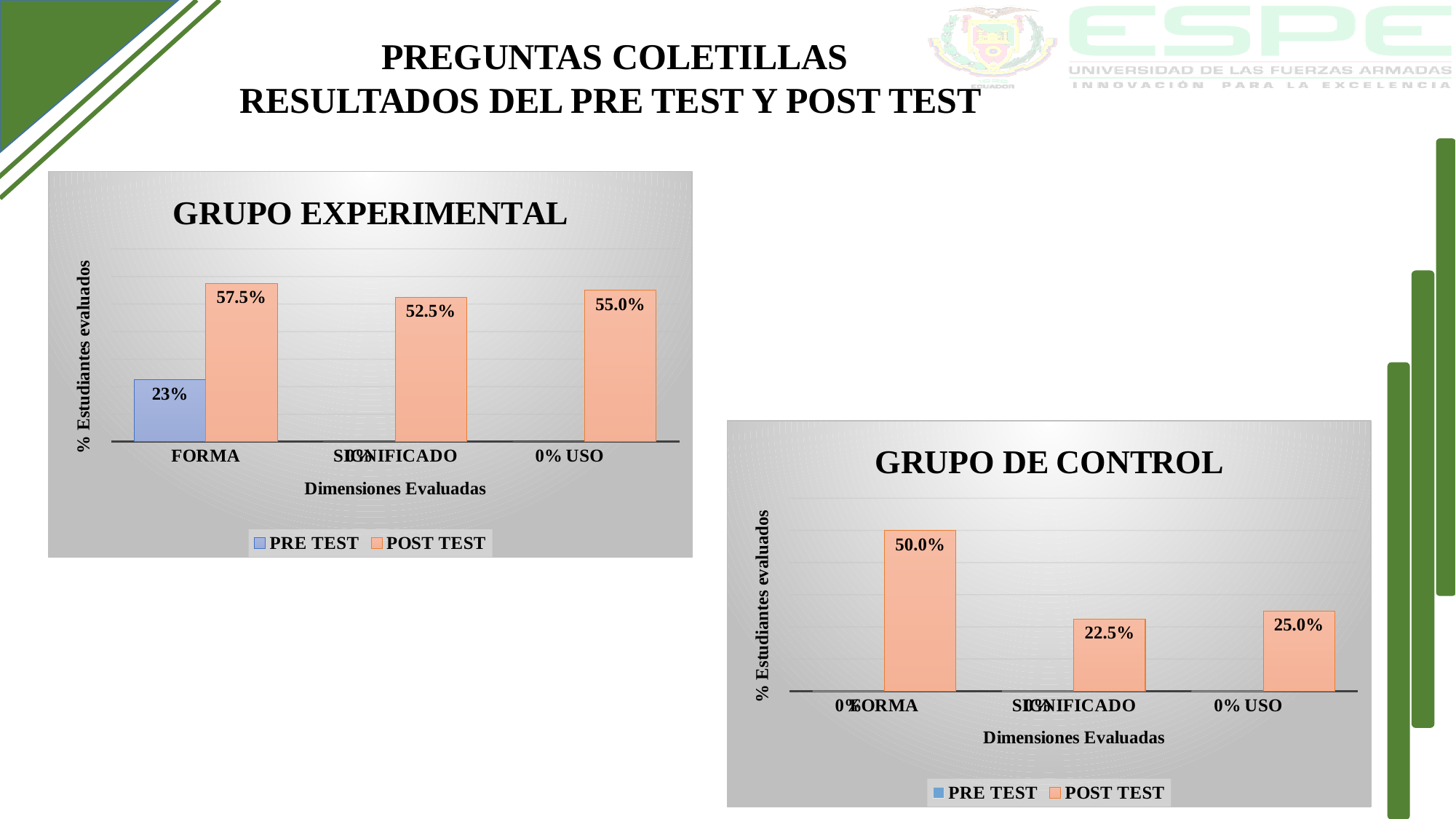
In the GRUPO EXPERIMENTAL chart, what is the PRE TEST value for FORMA? 23% In the GRUPO DE CONTROL chart, what is the POST TEST value for SIGNIFICADO? 22.5% In the GRUPO DE CONTROL chart, what is the POST TEST value for FORMA? 50.0% How many series does the legend of the GRUPO DE CONTROL chart list? 2 In the GRUPO DE CONTROL chart, which dimension has the lowest POST TEST value? SIGNIFICADO Which is larger in the GRUPO EXPERIMENTAL chart: the POST TEST value for FORMA or for USO? FORMA What kind of chart is the GRUPO EXPERIMENTAL chart? Bar chart In the GRUPO EXPERIMENTAL chart, what is the difference between the POST TEST and PRE TEST values for FORMA? 34.5% In the GRUPO EXPERIMENTAL chart, what is the POST TEST value for SIGNIFICADO? 52.5% In the GRUPO DE CONTROL chart, what is the difference between the POST TEST values for FORMA and USO? 25.0% In the GRUPO DE CONTROL chart, which dimension has the highest POST TEST value? FORMA In the GRUPO EXPERIMENTAL chart, what is the POST TEST value for FORMA? 57.5%